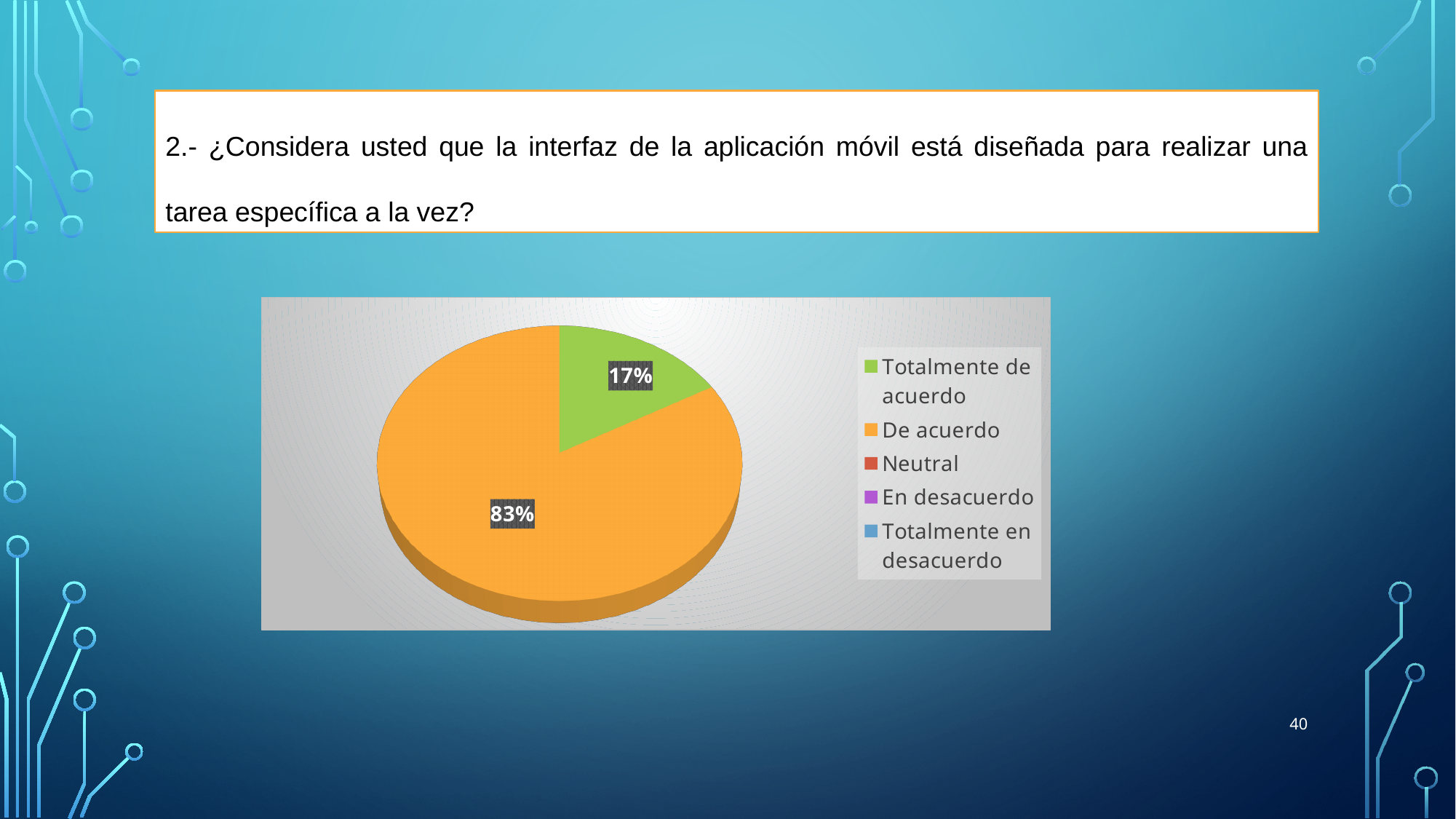
What share of the pie does "Totalmente de acuerdo" represent? 17% Which legend entry is shown in green? Totalmente de acuerdo What is the difference in percentage points between the "De acuerdo" slice and the "Totalmente de acuerdo" slice? 66% What colour is the "De acuerdo" slice? orange Is the share for "De acuerdo" greater or less than 50%? greater Which of the two visible slices is larger, "De acuerdo" or "Totalmente de acuerdo"? De acuerdo How many entries does the legend list? 5 How many slices are visible in the pie? 2 What share of the pie does "De acuerdo" represent? 83% What kind of chart is shown on the slide? pie chart Which category has the largest slice of the pie? De acuerdo